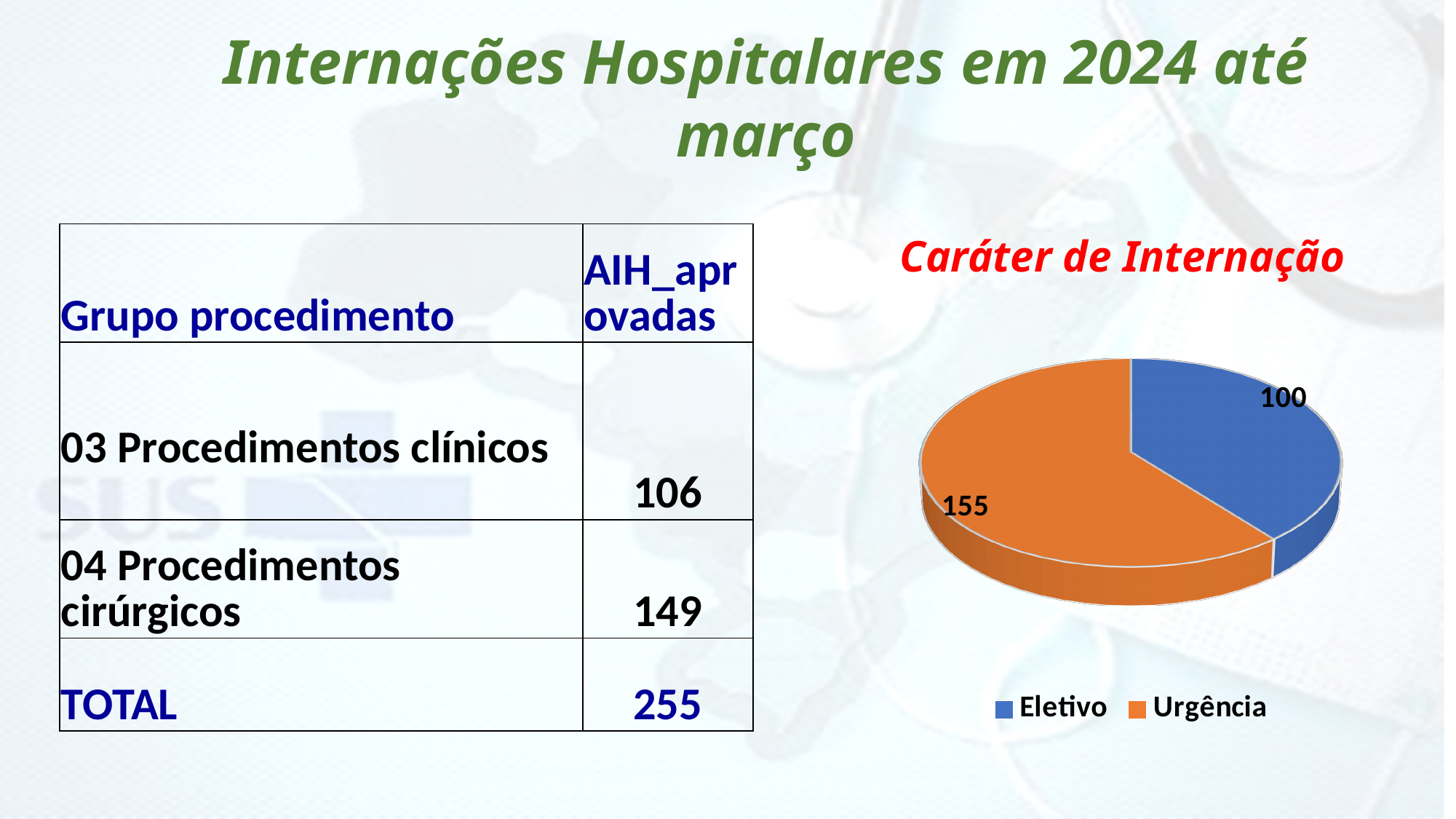
What is the difference between the Urgência and Eletivo values in the pie chart? 55 What kind of chart is shown on the slide? Pie chart Which category has the smallest slice in the pie chart? Eletivo What colour is the Urgência slice in the pie chart? Orange How many entries does the pie chart's legend list? 2 Which is larger in the pie chart, Eletivo or Urgência? Urgência How many slices does the pie chart have? 2 What is the value for Eletivo in the pie chart? 100 Which category has the largest slice in the pie chart? Urgência What is the value for Urgência in the pie chart? 155 What is the total of the two values shown in the pie chart? 255 What is the title of the pie chart? Caráter de Internação